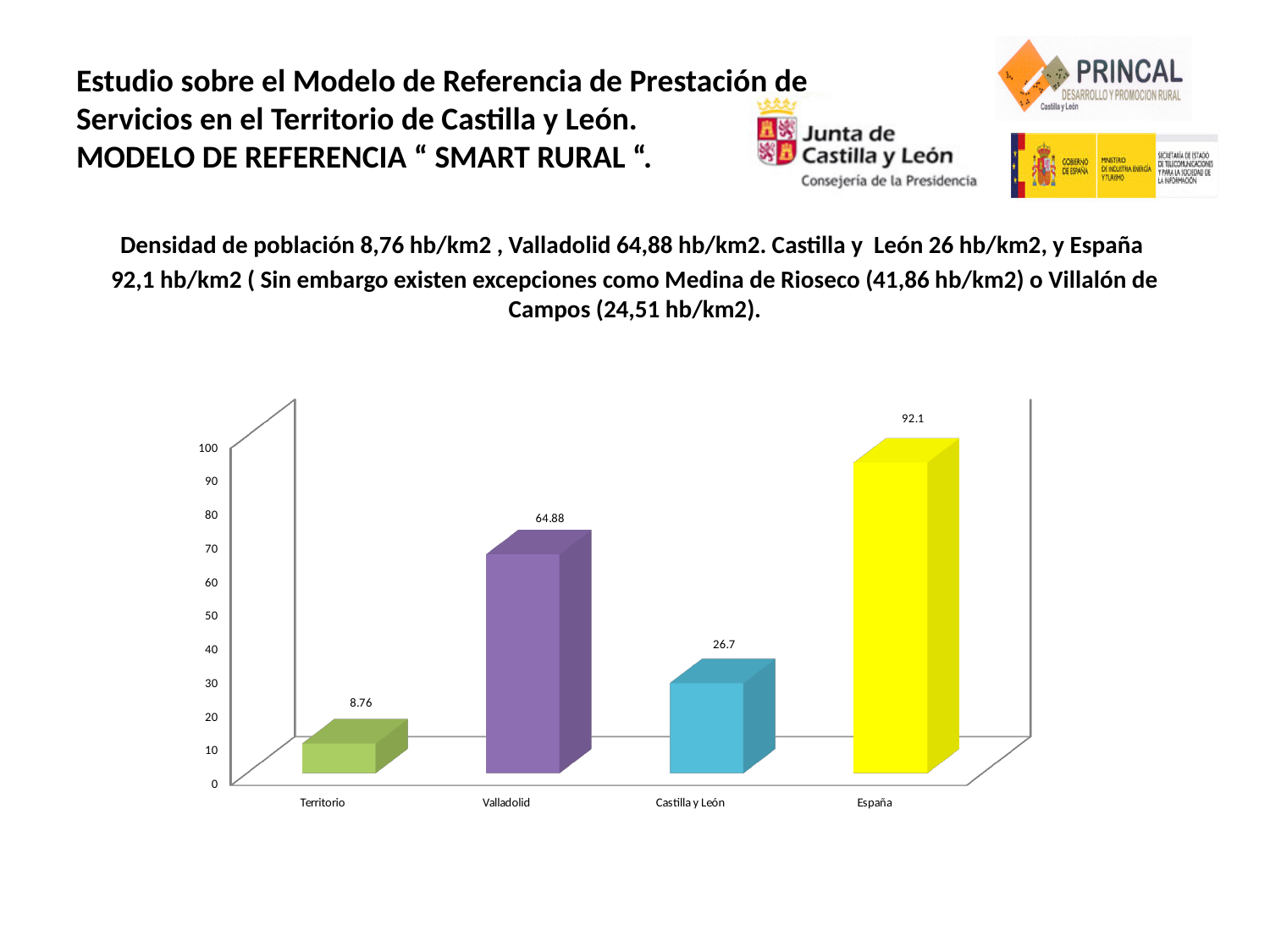
Which is larger, the value for Valladolid or the value for Castilla y León? Valladolid What is the value for Territorio in the chart? 8.76 What kind of chart is shown on the slide? bar chart What is the value for Valladolid in the chart? 64.88 Which category has the highest value in the chart? España Which category has the lowest value in the chart? Territorio What is the value for España in the chart? 92.1 What is the difference between the values for España and Valladolid? 27.22 What is the difference between the values for Castilla y León and Territorio? 17.94 What is the value for Castilla y León in the chart? 26.7 Is the value for España greater or less than 90? greater How many categories are shown on the x axis of the chart? 4